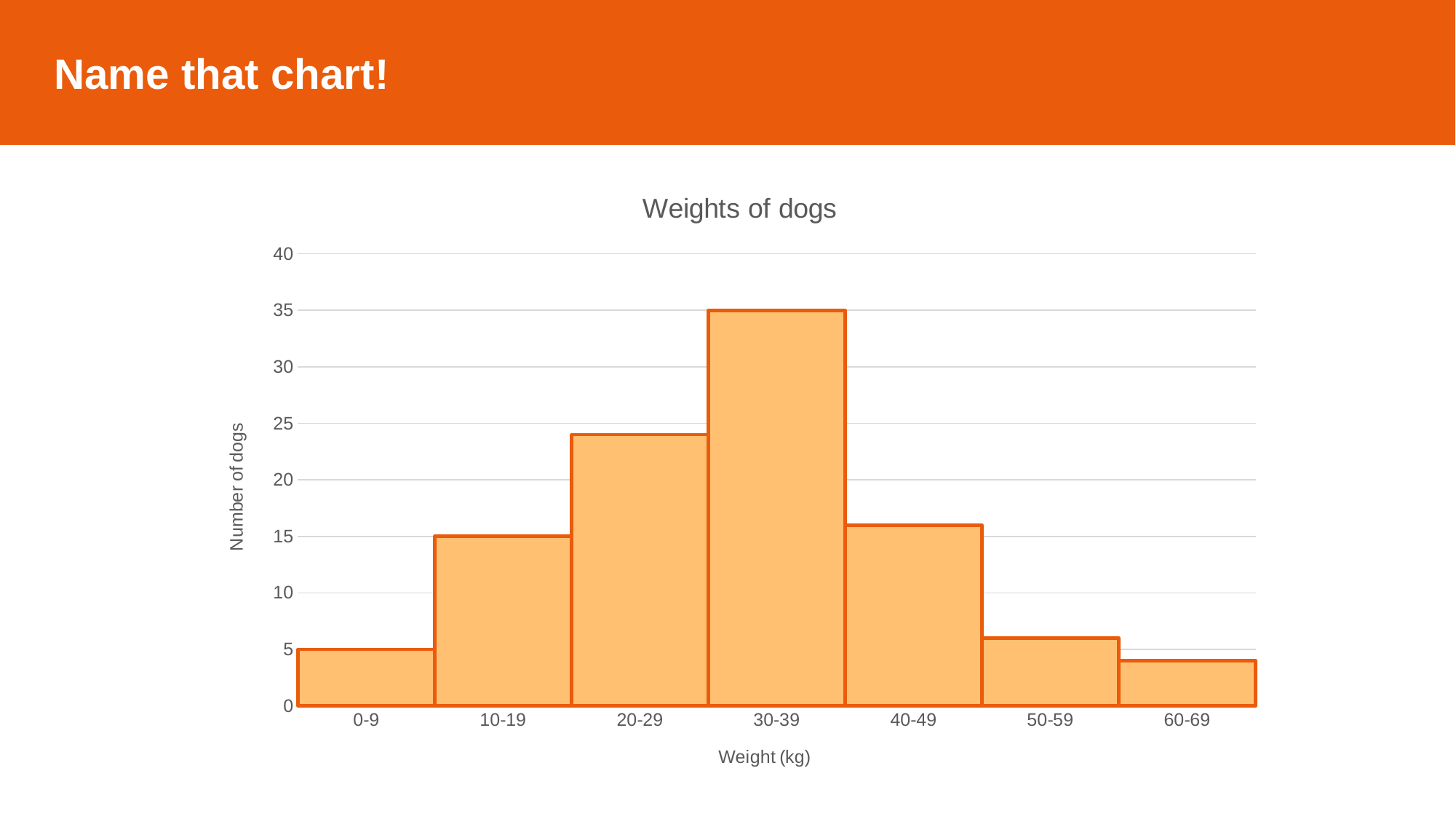
Is the number of dogs in the 50-59 kg category greater or less than 10? less What is the number of dogs in the 0-9 kg weight category? 5 What type of chart is shown on the slide? bar chart How many weight categories are shown on the x axis? 7 Which category has more dogs, 20-29 kg or 40-49 kg? 20-29 What is the title of the chart? Weights of dogs Which weight category has the lowest number of dogs? 60-69 What is the number of dogs in the 30-39 kg weight category? 35 What is the difference in the number of dogs between the 30-39 kg and 10-19 kg categories? 20 Which weight category has the highest number of dogs? 30-39 Is the number of dogs in the 20-29 kg category greater or less than 20? greater What is the number of dogs in the 10-19 kg weight category? 15